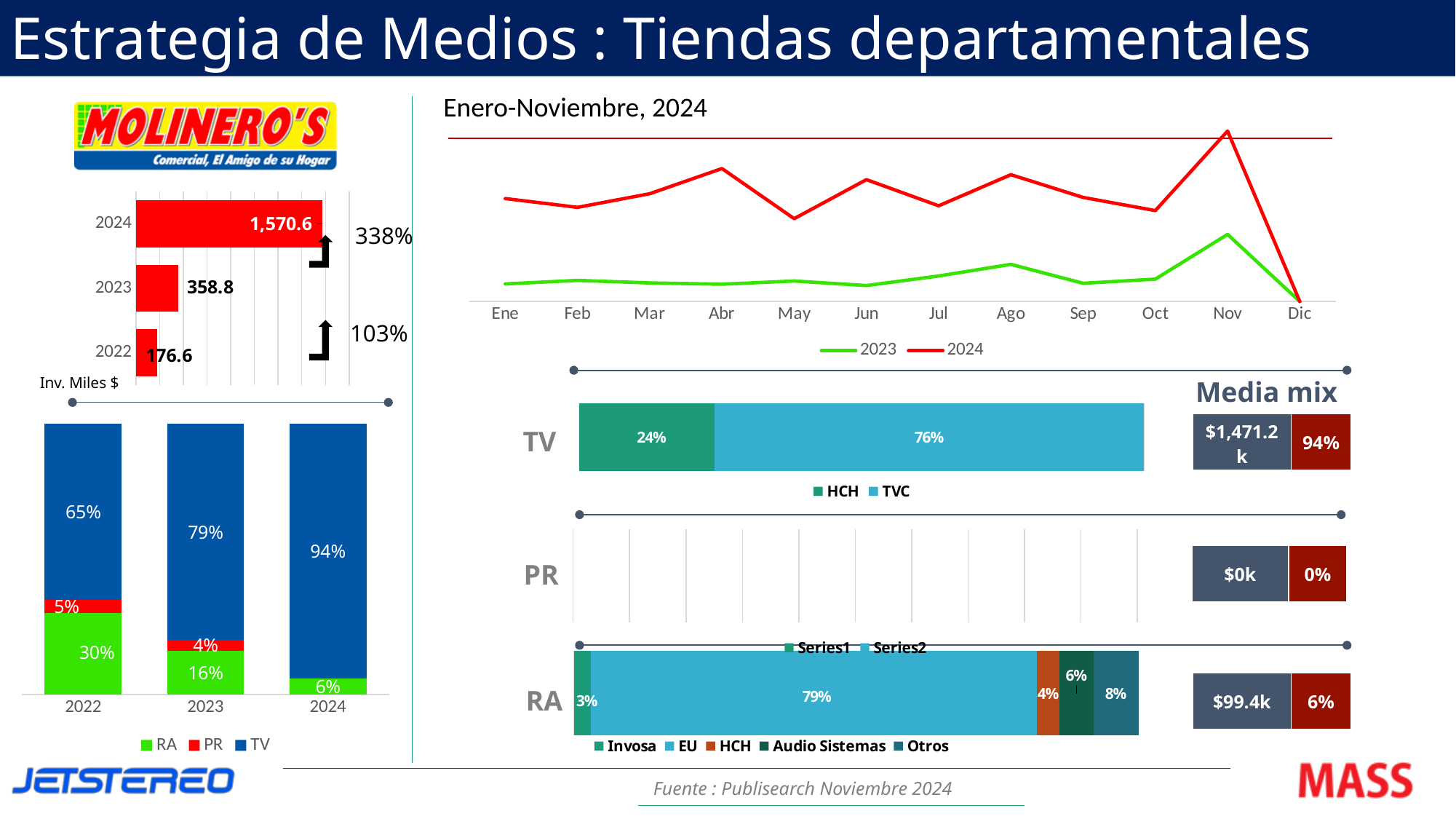
In the top-left bar chart of yearly investment, what is the difference between the 2023 and 2022 values? 182.2 In the bottom-left stacked bar chart, how many series does the legend list? 3 In the top-left bar chart of yearly investment, what percentage growth is shown between 2023 and 2024? 338% In the top-left bar chart of yearly investment, which year has the highest value? 2024 In the top-left bar chart of yearly investment (Inv. Miles $), what is the value for 2022? 176.6 In the line chart titled 'Enero-Noviembre, 2024', in which month does the 2024 line reach its highest point? Nov In the line chart titled 'Enero-Noviembre, 2024', what kind of chart is it? line chart In the top-left bar chart of yearly investment (Inv. Miles $), what is the value for 2024? 1,570.6 In the bottom-left stacked bar chart, does the RA share rise or fall from 2022 to 2024? fall In the bottom-left stacked bar chart, what is the RA share for 2022? 30% In the TV media mix bar on the right, what is the share for TVC? 76% In the bottom-left stacked bar chart, what is the TV share for 2023? 79%